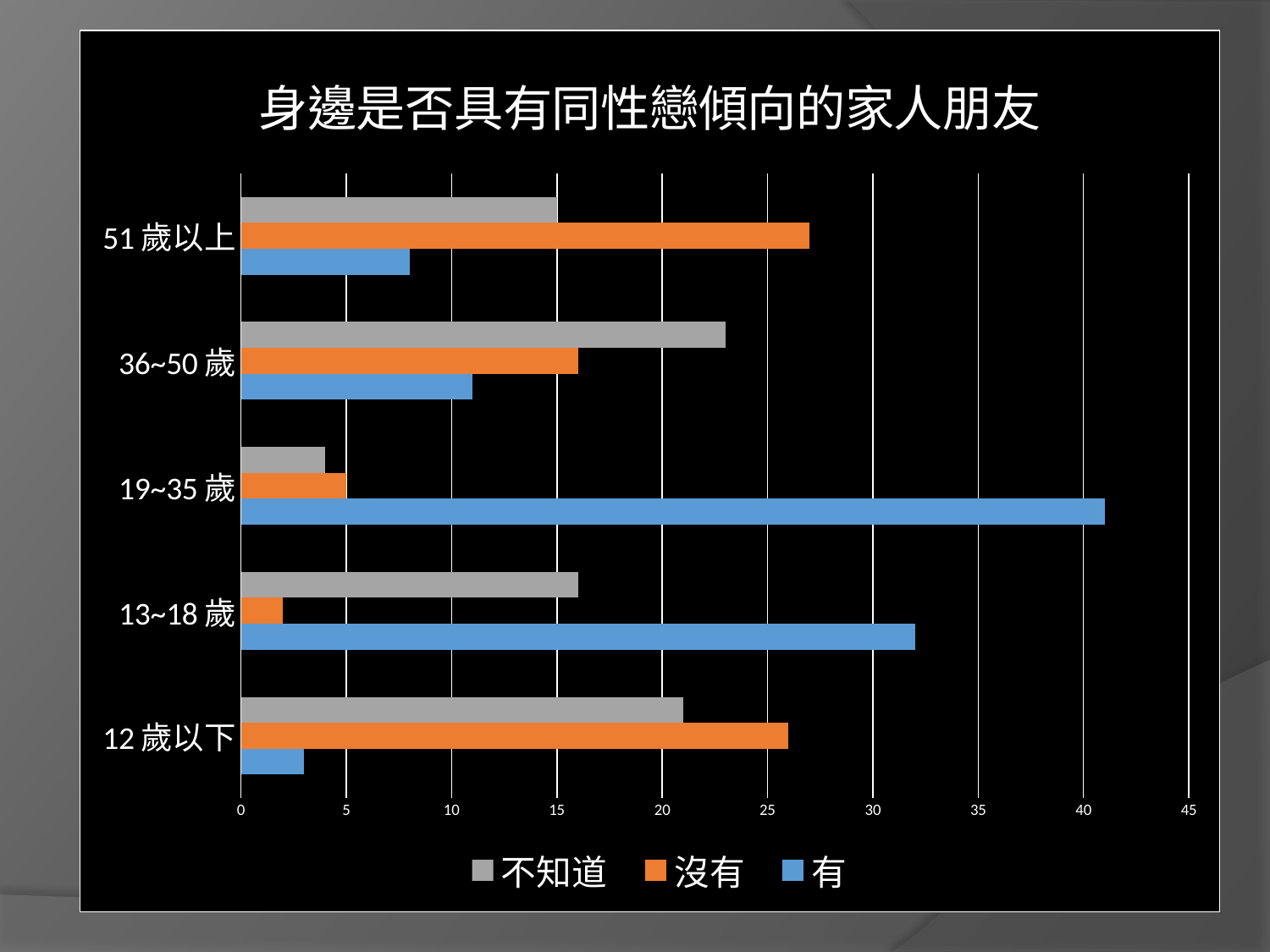
Is the value for 有 in the 13~18 歲 group greater or less than 30? greater Is the value for 沒有 in the 13~18 歲 group greater or less than 5? less Is the value for 有 in the 19~35 歲 group greater or less than 35? greater What kind of chart is shown on the slide? bar chart How many age groups are shown on the chart? 5 For the 12 歲以下 group, which is larger: 有 or 不知道? 不知道 How many series does the legend list? 3 Which age group has the lowest value for 有? 12 歲以下 For the 51 歲以上 group, which is larger: 沒有 or 不知道? 沒有 Which age group has the highest value for 有? 19~35 歲 What is the title of the chart? 身邊是否具有同性戀傾向的家人朋友